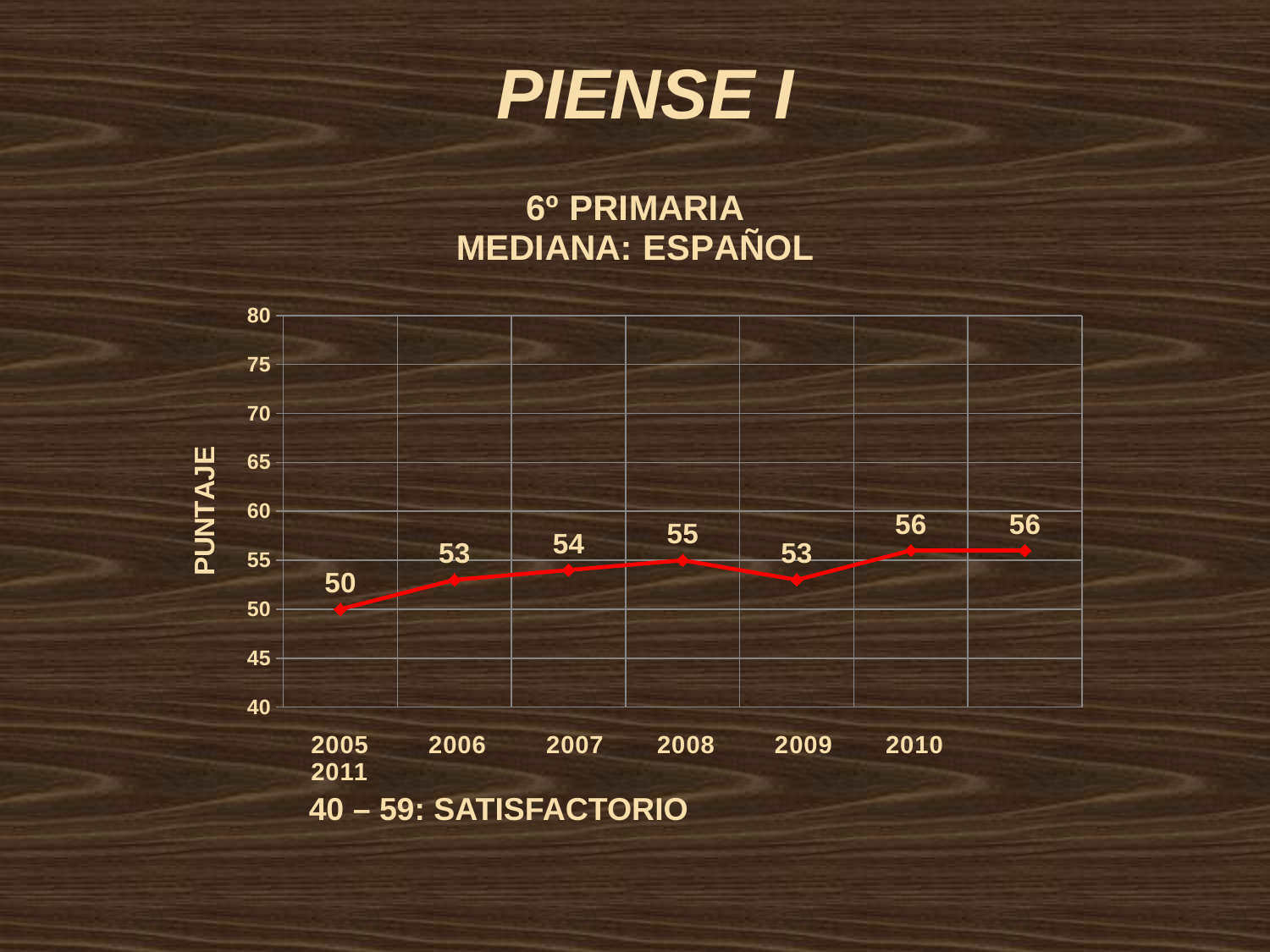
Which year has the lowest value? 2005 What is the label on the vertical axis? PUNTAJE What is the value for 2005? 50 Is the value for 2006 greater or less than 60? less What is the difference between the values for 2010 and 2005? 6 Which is larger, the value for 2008 or the value for 2009? 2008 How many data points are plotted on the line? 7 What is the value for 2009? 53 What type of chart is shown on the slide? line chart What is the value for 2008? 55 What is the value for 2010? 56 What is the value for 2007? 54